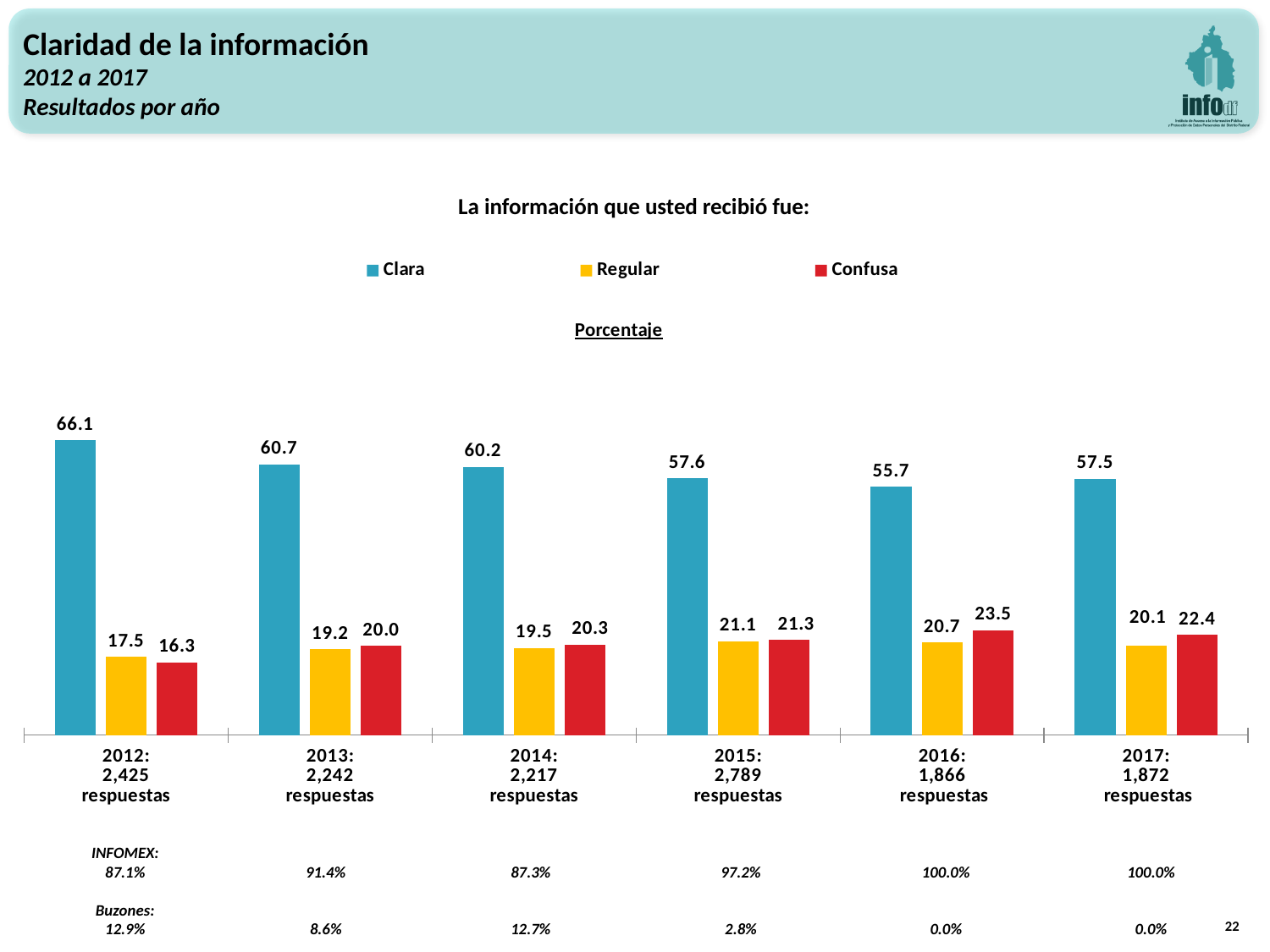
What is the value for Regular in 2015? 21.1 Which year has the highest value for Clara? 2012 What kind of chart is shown? Bar chart Which colour represents the Confusa series? Red How many years are shown on the x axis? 6 Which year has the lowest value for Clara? 2016 What is the value for Confusa in 2016? 23.5 In 2012, which is larger, Regular or Confusa? Regular What is the value for Clara in 2012? 66.1 In 2017, which is larger, Regular or Confusa? Confusa How many series does the legend list? 3 What is the difference between the Clara values for 2012 and 2017? 8.6